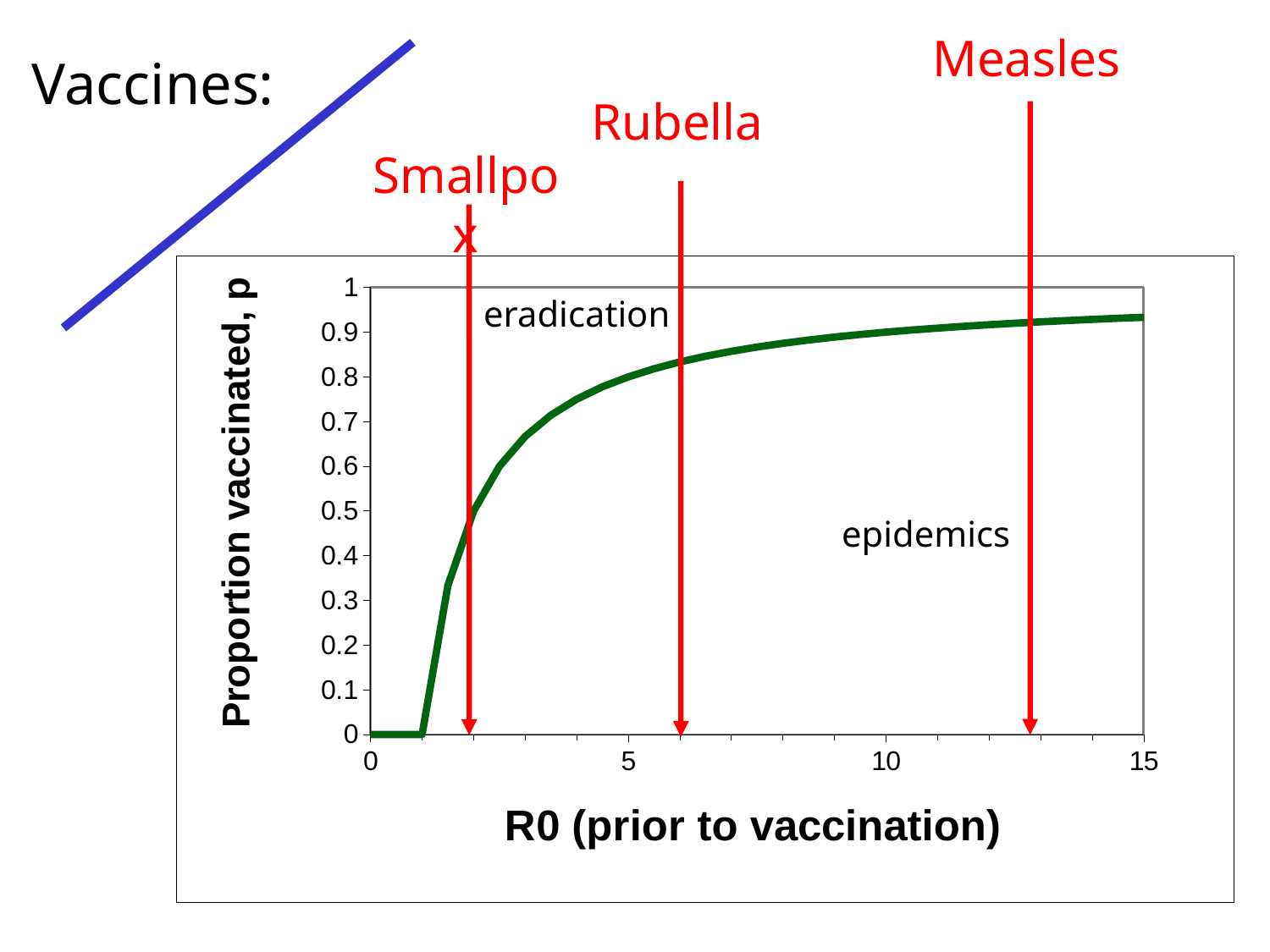
How many diseases are marked with red arrows on the chart? 3 Which of the labelled diseases is marked at the highest R0 value? Measles What kind of chart is shown on the slide? line chart Is the value of the green curve at the R0 marked by the Measles arrow greater or less than 0.8? greater Is the value of the green curve at R0 = 5 greater or less than 0.7? greater What is the title of the x axis of the chart? R0 (prior to vaccination) Which of the labelled diseases is marked at the lowest R0 value? Smallpox What is the title of the y axis of the chart? Proportion vaccinated, p Does the green curve rise or fall as R0 increases along the x axis? rises Is the value of the green curve at R0 = 0.5 greater or less than 0.1? less What is the value of the green curve at R0 = 0? 0